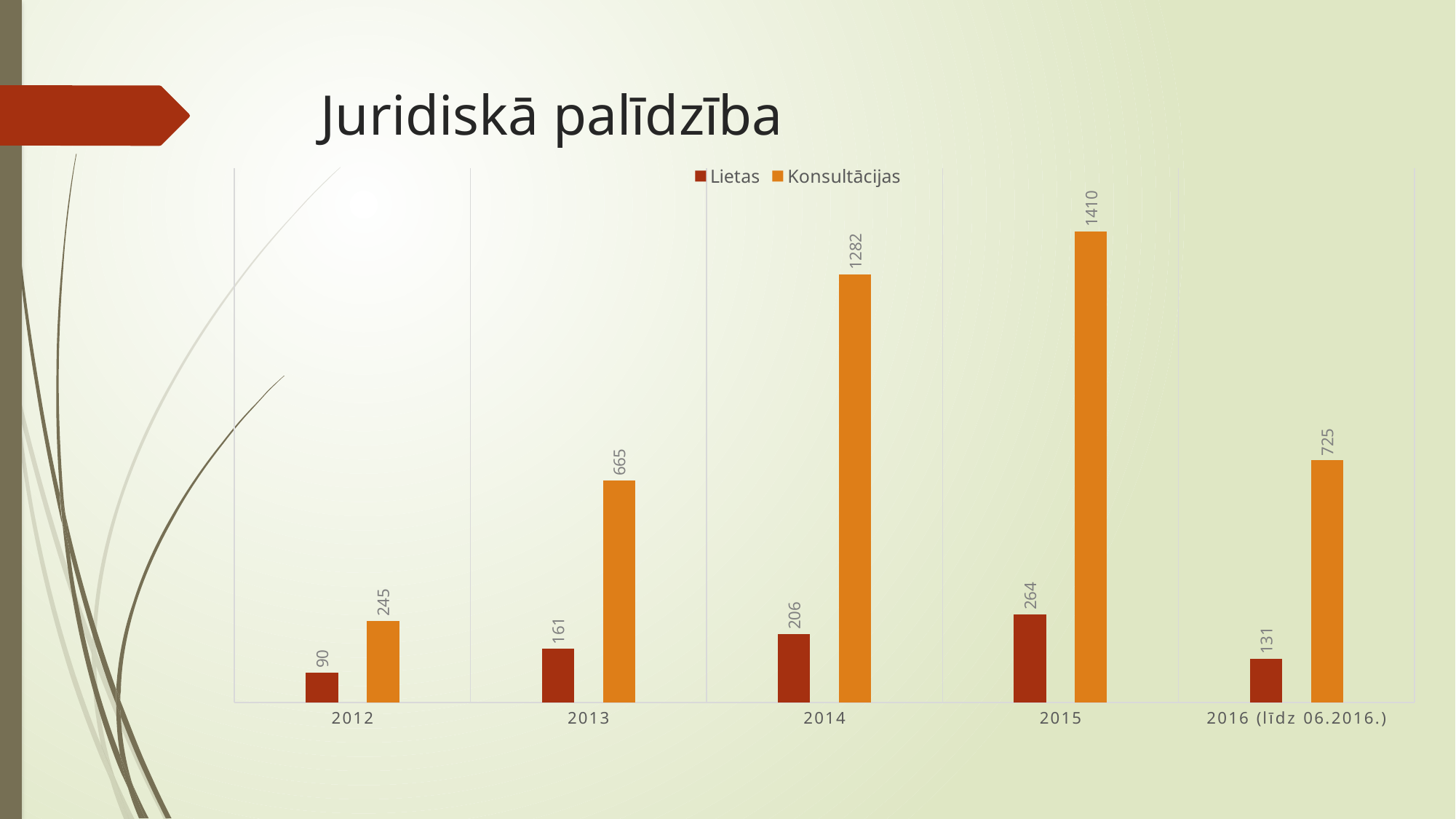
Which year has the highest value for Konsultācijas? 2015 What is the value of Konsultācijas for 2015? 1410 What is the value of Konsultācijas for 2016 (līdz 06.2016.)? 725 What is the difference between Konsultācijas and Lietas in 2014? 1076 How many categories are shown on the x axis? 5 Which year has the lowest value for Lietas? 2012 Which is larger: Lietas in 2015 or Lietas in 2013? Lietas in 2015 How many series does the legend list? 2 What kind of chart is shown on the slide? Bar chart Do the Konsultācijas values rise or fall from 2012 to 2015? Rise What is the value of Lietas for 2012? 90 What is the title of the slide? Juridiskā palīdzība